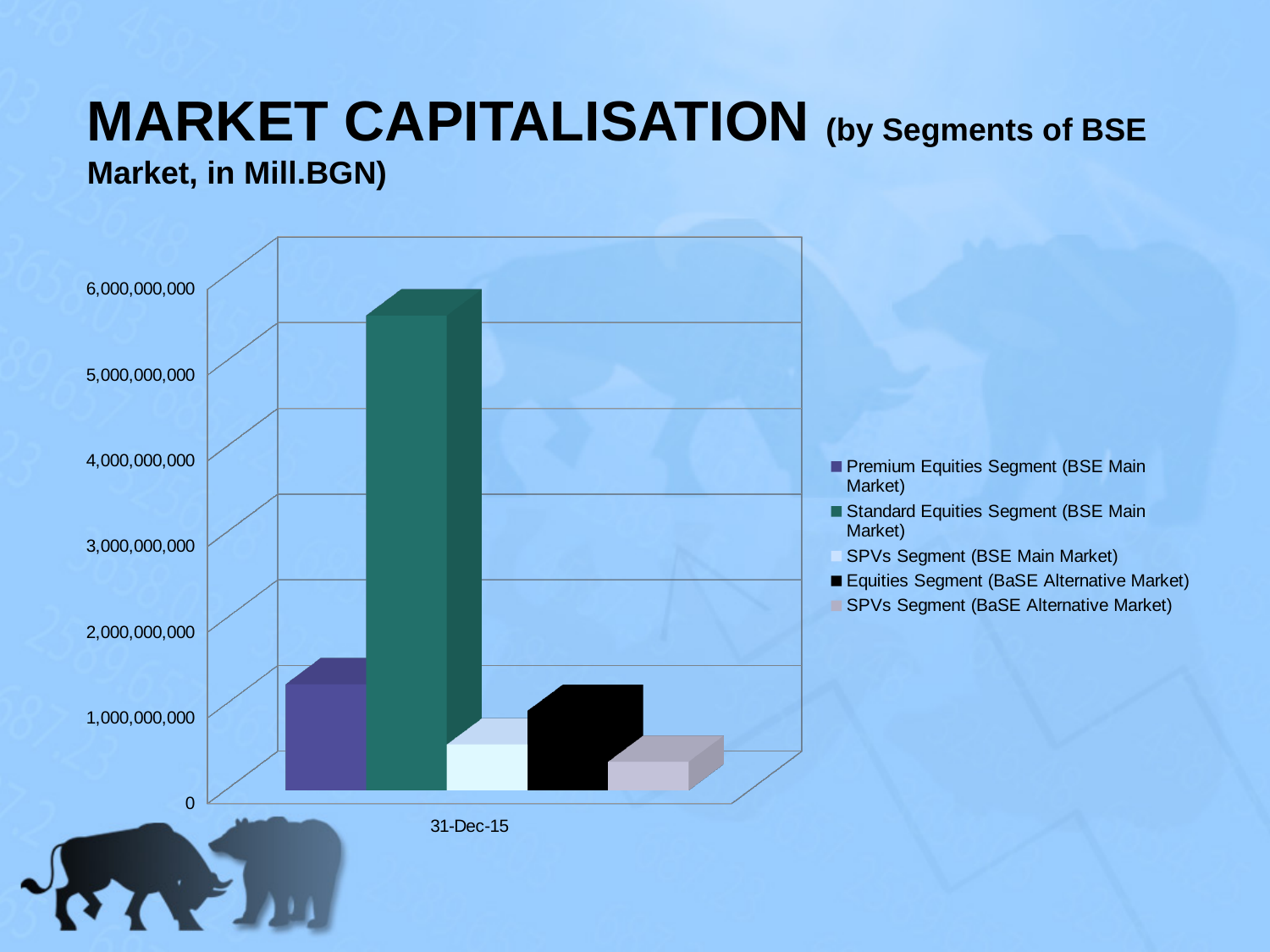
Is the value for SPVs Segment (BSE Main Market) greater or less than 1,000,000,000? less Which segment has the lowest market capitalisation? SPVs Segment (BaSE Alternative Market) Which is larger, the value for Premium Equities Segment (BSE Main Market) or Equities Segment (BaSE Alternative Market)? Premium Equities Segment (BSE Main Market) How many categories are shown on the x axis? 1 What colour is the bar for Standard Equities Segment (BSE Main Market)? green How many series does the legend list? 5 Is the value for Standard Equities Segment (BSE Main Market) greater or less than 5,000,000,000? greater Is the value for SPVs Segment (BaSE Alternative Market) greater or less than 1,000,000,000? less What kind of chart is shown on the slide? bar chart What date is shown as the category label on the x axis? 31-Dec-15 Which segment has the highest market capitalisation? Standard Equities Segment (BSE Main Market)